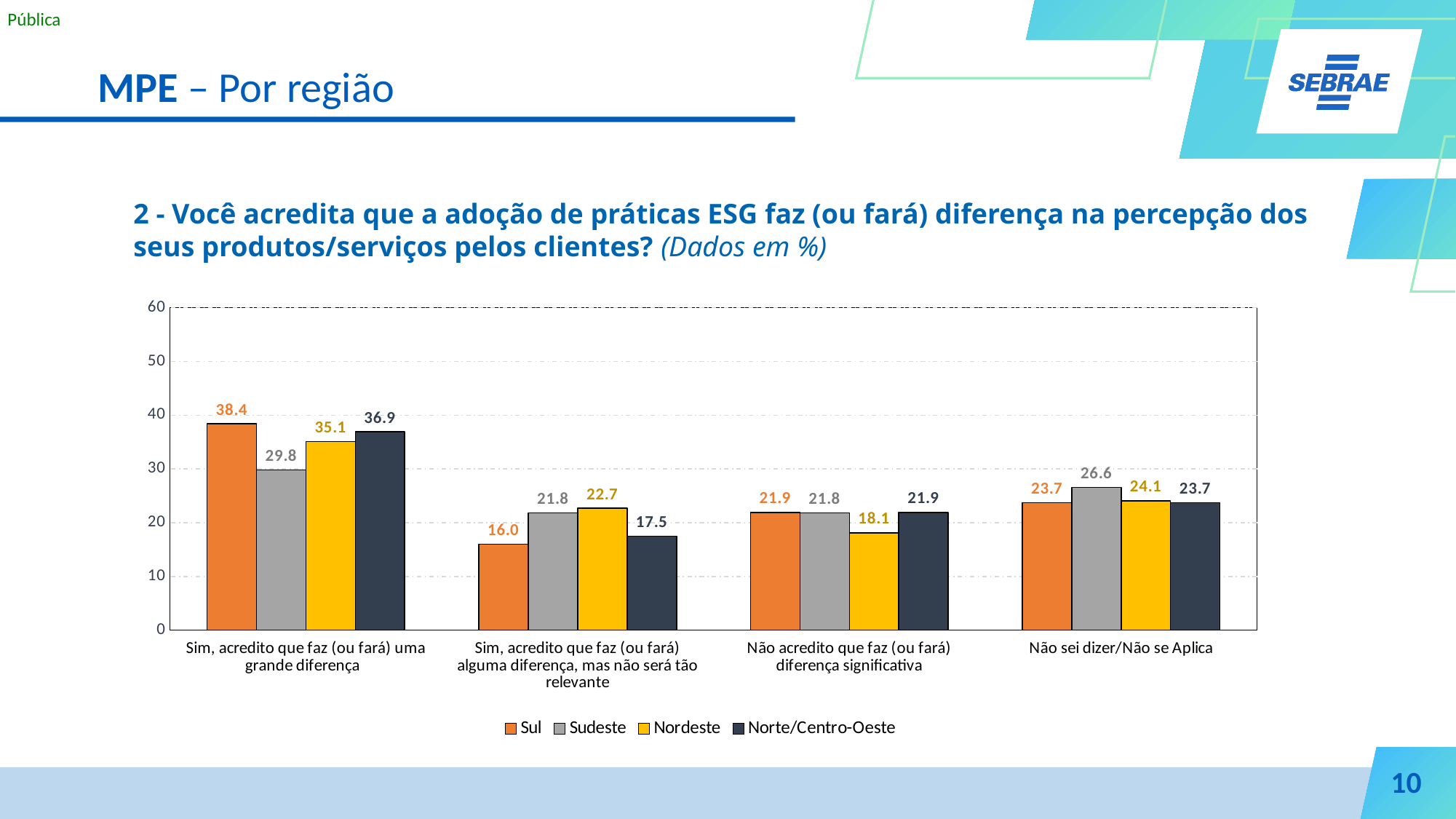
What is the value for Nordeste in the category "Não acredito que faz (ou fará) diferença significativa"? 18.1 What is the value for Sul in the category "Sim, acredito que faz (ou fará) uma grande diferença"? 38.4 What is the value for Sudeste in the category "Não sei dizer/Não se Aplica"? 26.6 What kind of chart is shown on the slide? Bar chart In the category "Não sei dizer/Não se Aplica", which is larger: the value for Sudeste or the value for Nordeste? Sudeste Is the value for Nordeste in the category "Sim, acredito que faz (ou fará) uma grande diferença" greater or less than 30? greater How many response categories are shown on the x axis of the chart? 4 Which region has the lowest value in the category "Sim, acredito que faz (ou fará) alguma diferença, mas não será tão relevante"? Sul How many series does the chart legend list? 4 What is the difference between the Sul and Sudeste values in the category "Sim, acredito que faz (ou fará) uma grande diferença"? 8.6 What is the value for Norte/Centro-Oeste in the category "Sim, acredito que faz (ou fará) alguma diferença, mas não será tão relevante"? 17.5 Which region has the highest value in the category "Sim, acredito que faz (ou fará) uma grande diferença"? Sul